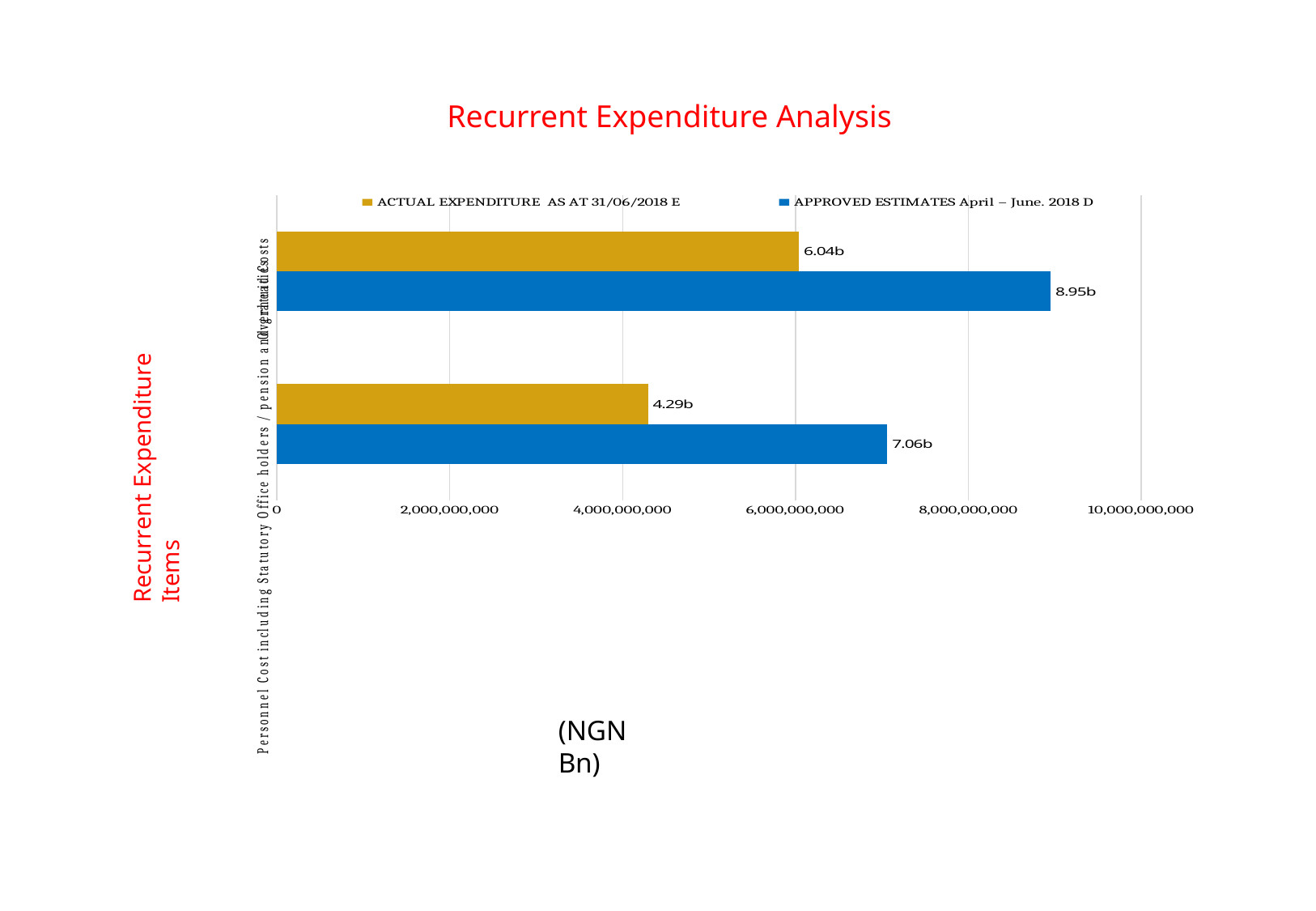
What is the value of the ACTUAL EXPENDITURE bar in the bottom group of bars? 4.29b In the top group of bars, what is the difference between the APPROVED ESTIMATES value and the ACTUAL EXPENDITURE value? 2.91b Which bar in the chart has the lowest value? ACTUAL EXPENDITURE in the bottom group (4.29b) What kind of chart is shown on the slide? bar chart Which bar in the chart has the highest value? APPROVED ESTIMATES in the top group (8.95b) How many series does the chart legend list? 2 How many categories (groups of bars) are plotted in the chart? 2 What is the value of the APPROVED ESTIMATES bar in the top group of bars? 8.95b What colour are the ACTUAL EXPENDITURE bars in the chart? gold What is the value of the ACTUAL EXPENDITURE bar in the top group of bars? 6.04b What is the value of the APPROVED ESTIMATES bar in the bottom group of bars? 7.06b In the bottom group of bars, which is larger: the ACTUAL EXPENDITURE value or the APPROVED ESTIMATES value? APPROVED ESTIMATES